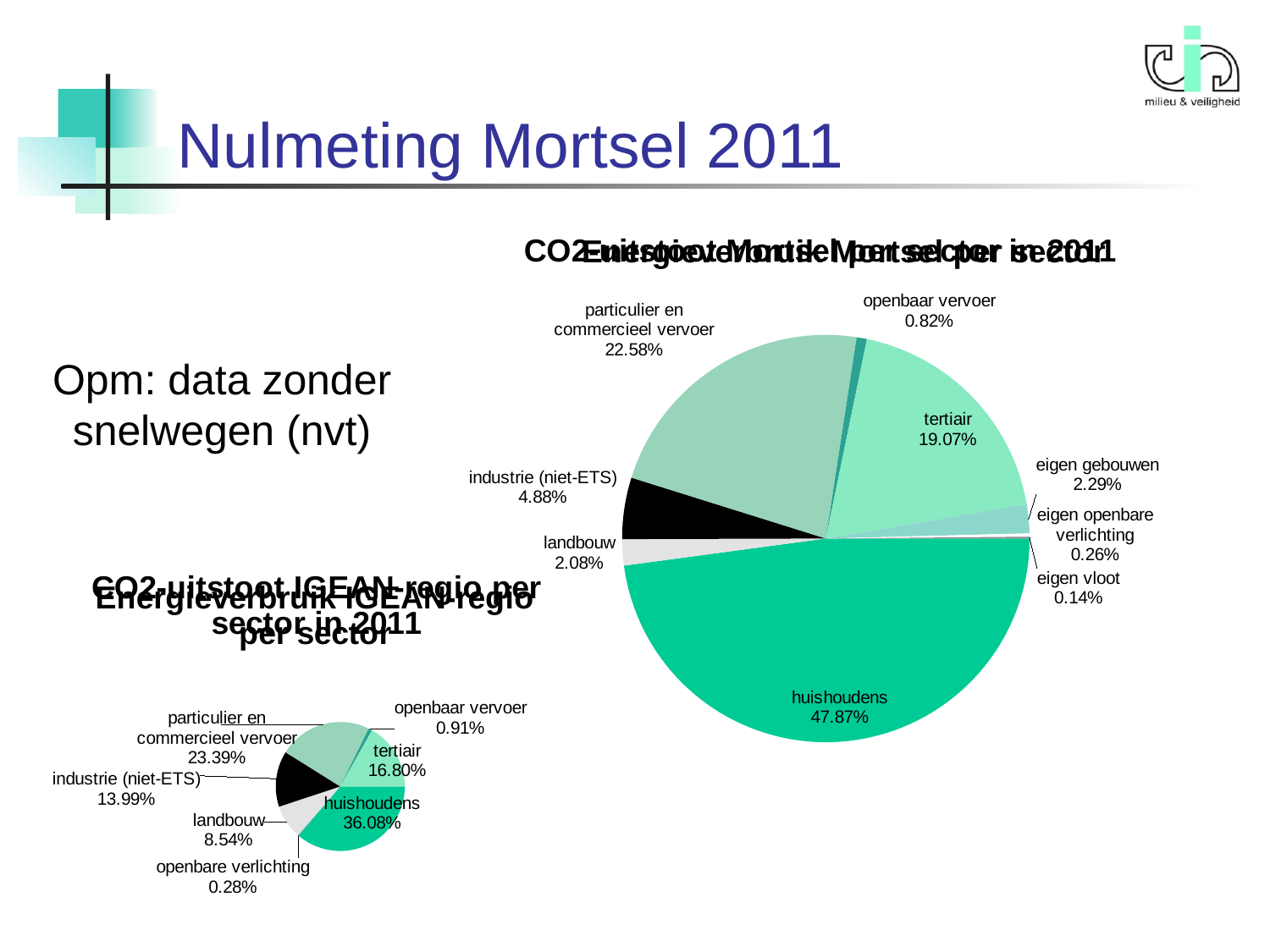
In the small pie chart at the bottom left, what share does industrie (niet-ETS) have? 13.99% What type of chart is the large chart on the right? pie chart In the large pie chart on the right, what is the value for tertiair? 19.07% In the large pie chart on the right, what is the difference between particulier en commercieel vervoer and tertiair? 3.51% In the large pie chart on the right, which sector has the largest share? huishoudens In the small pie chart at the bottom left, which sector has the smallest share? openbare verlichting In the large pie chart on the right, what share does huishoudens have? 47.87% In the large pie chart on the right, which sector has the smallest share? eigen vloot In the large pie chart on the right, which is larger: industrie (niet-ETS) or landbouw? industrie (niet-ETS) In the small pie chart at the bottom left, how many slices are there? 7 In the large pie chart on the right, how many slices are there? 9 In the small pie chart at the bottom left, what is the value for huishoudens? 36.08%